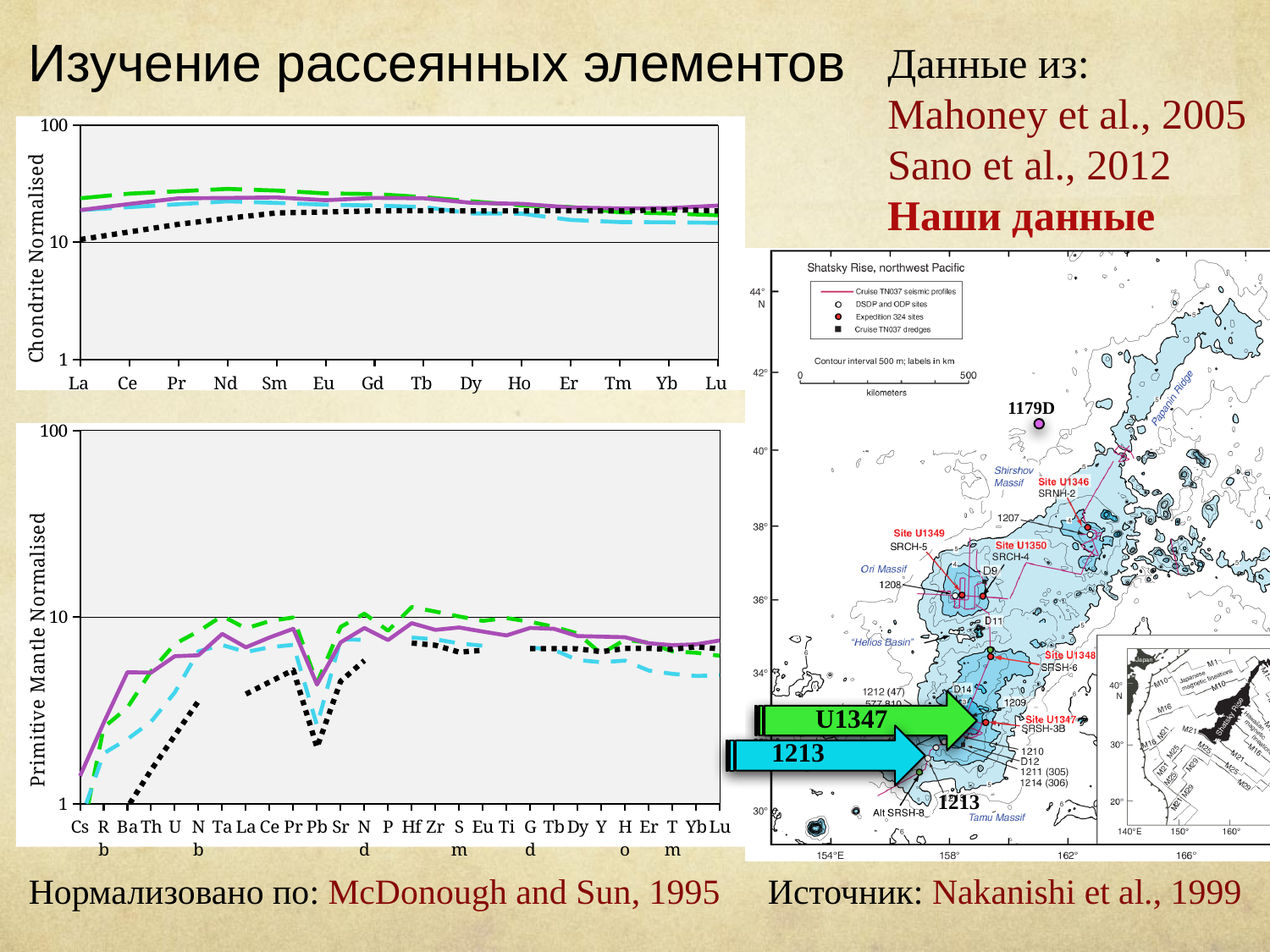
What kind of chart is the top chart on the slide? line chart In the bottom chart, does the purple solid line rise or fall from Cs to Ba? rise In the top chart, does the black dotted line rise or fall from La to Lu? rise What is the y-axis title of the bottom chart? Primitive Mantle Normalised In the bottom chart, is the value of the black dotted line at Pb greater or less than 10? less How many elements are listed along the x axis of the bottom chart? 28 In the top chart, is the value of the green dashed line at Nd greater or less than 10? greater What is the y-axis title of the top chart? Chondrite Normalised In the bottom chart, is the value of the purple solid line at Cs greater or less than 10? less How many elements are listed along the x axis of the top chart? 14